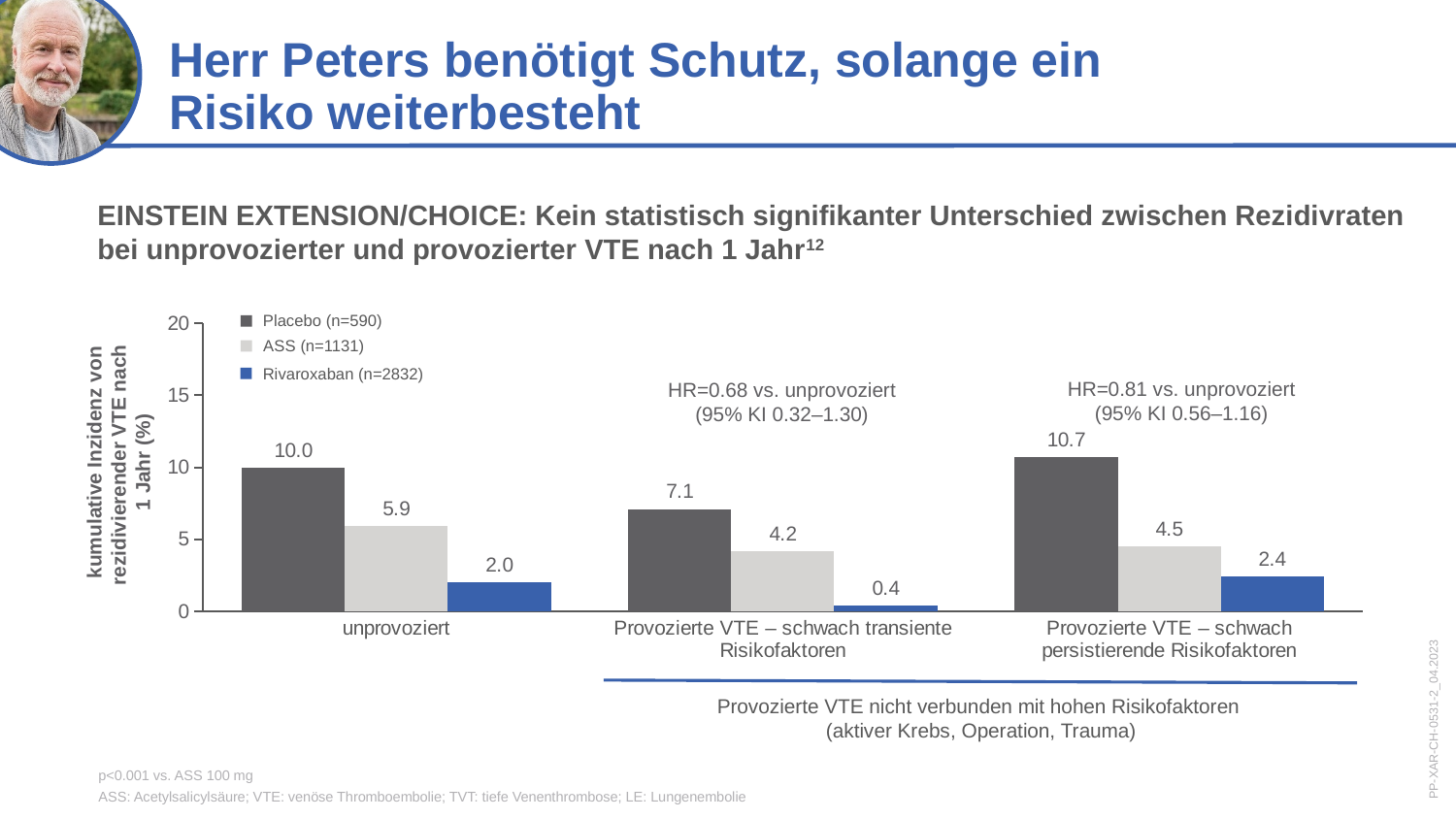
What is the value for ASS in the 'Provozierte VTE – schwach persistierende Risikofaktoren' category? 4.5 Which category has the lowest Rivaroxaban value? Provozierte VTE – schwach transiente Risikofaktoren Which is larger: the ASS value for 'unprovoziert' or the ASS value for 'Provozierte VTE – schwach transiente Risikofaktoren'? unprovoziert What is the value for Rivaroxaban in the 'Provozierte VTE – schwach transiente Risikofaktoren' category? 0.4 How many categories are shown on the x axis? 3 Which category has the highest Placebo value? Provozierte VTE – schwach persistierende Risikofaktoren What kind of chart is shown on the slide? bar chart What is the value for Placebo in the 'unprovoziert' category? 10.0 What is the sample size (n) for the Rivaroxaban series in the legend? 2832 What is the difference between the Placebo and Rivaroxaban values in the 'unprovoziert' category? 8.0 How many series does the legend list? 3 What is the label of the y axis? kumulative Inzidenz von rezidivierender VTE nach 1 Jahr (%)